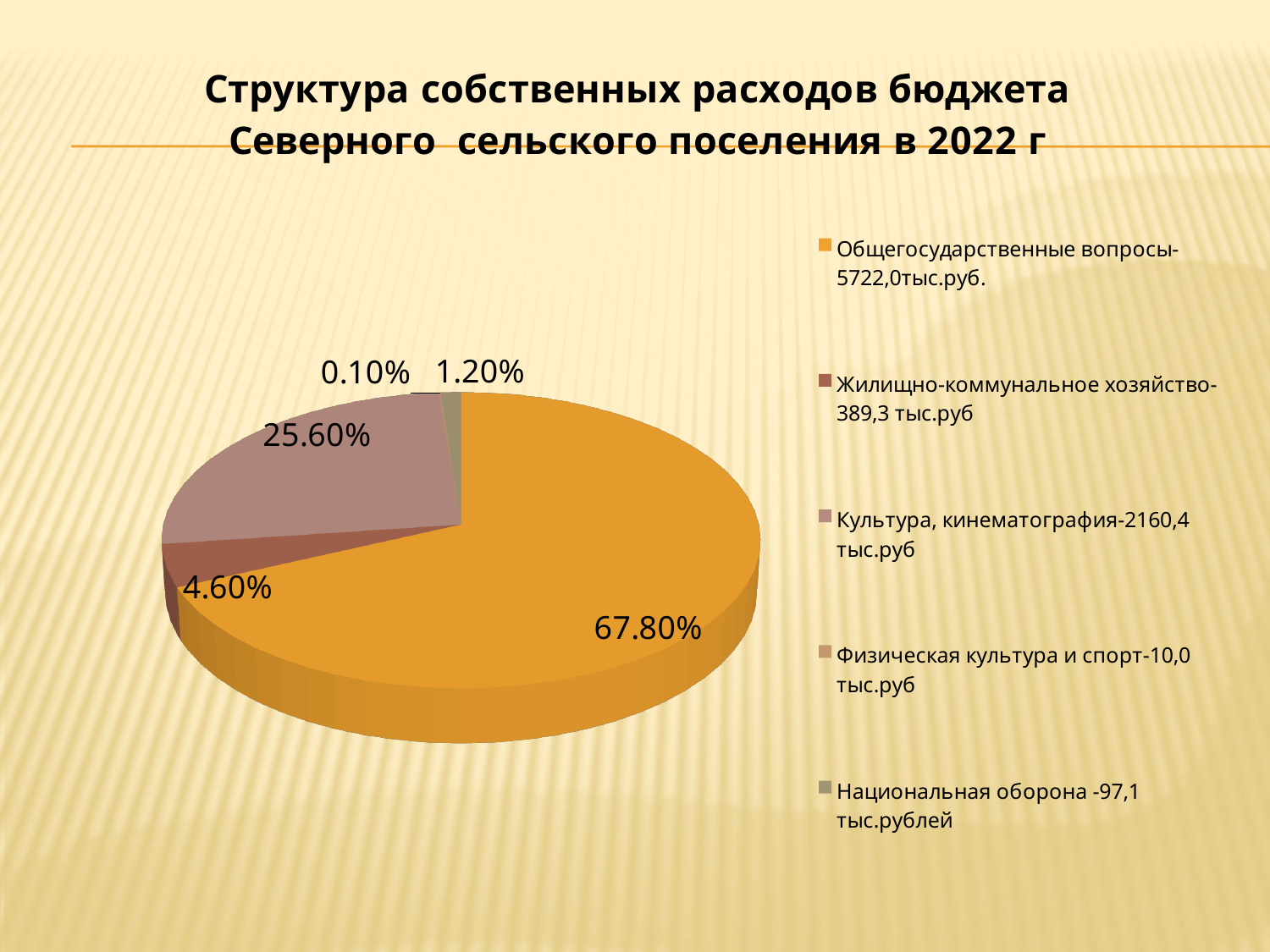
Which is larger: the share for Жилищно-коммунальное хозяйство or the share for Национальная оборона? Жилищно-коммунальное хозяйство What percentage is shown for Культура, кинематография? 25.60% Which category has the largest share of the pie? Общегосударственные вопросы Which category has the smallest share of the pie? Физическая культура и спорт How many entries does the legend list? 5 How many slices does the pie chart have? 5 What percentage is shown for Национальная оборона? 1.20% What percentage is shown for Жилищно-коммунальное хозяйство? 4.60% What kind of chart is shown on the slide? Pie chart What amount in thousand rubles does the legend give for Культура, кинематография? 2160,4 тыс.руб What is the difference in percentage points between Общегосударственные вопросы and Культура, кинематография? 42.20% What share of the pie does Общегосударственные вопросы account for? 67.80%